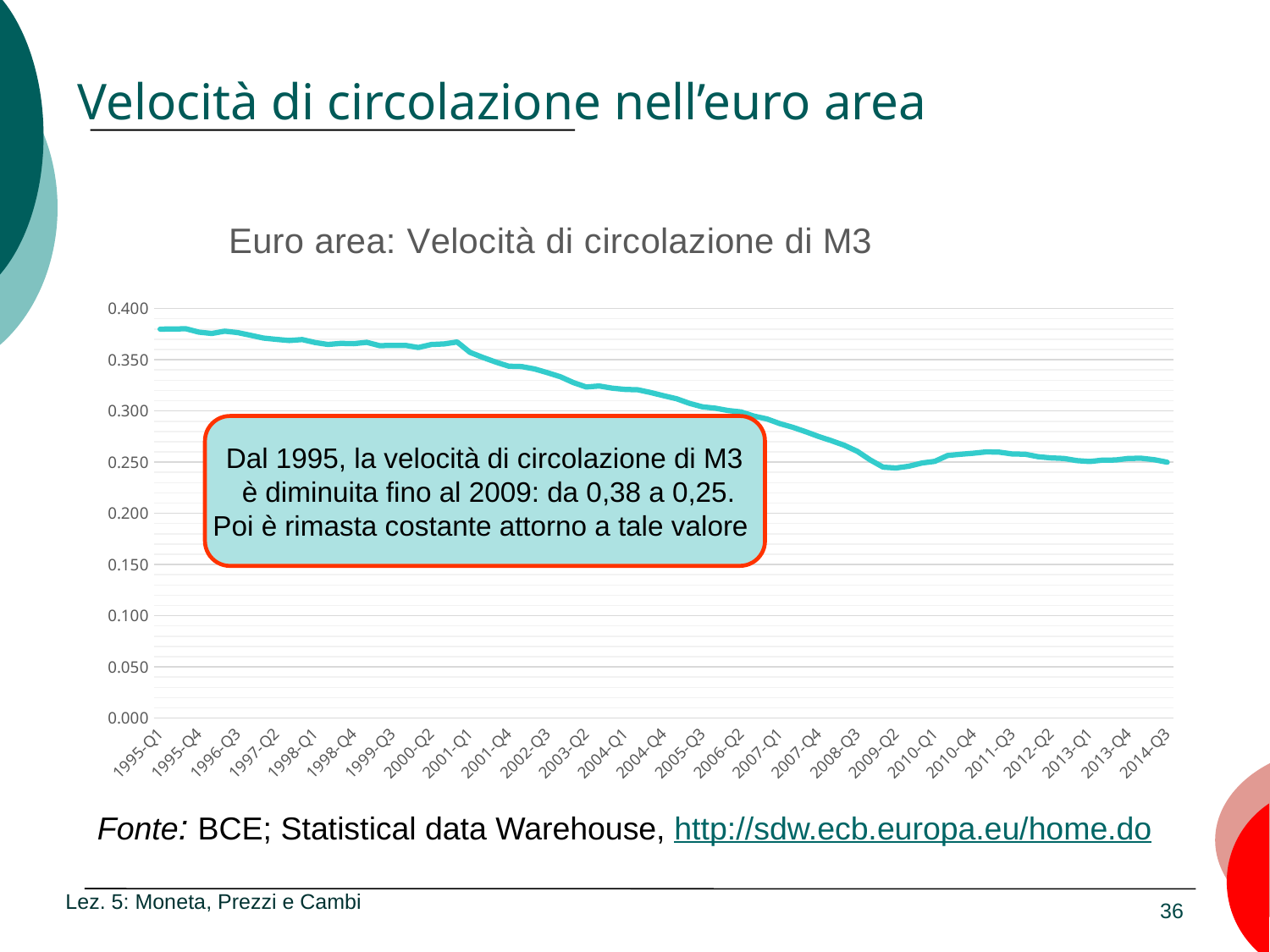
Is the value for 1995-Q1 greater or less than 0.350? greater Does the velocity of circulation of M3 generally rise or fall from 1995-Q1 to 2009-Q2? fall What kind of chart is shown on the slide? line chart What is the title of the chart? Euro area: Velocità di circolazione di M3 Which is larger, the value for 1995-Q1 or the value for 2014-Q3? 1995-Q1 What is the highest value shown on the vertical axis? 0.400 Is the value for 2009-Q2 greater or less than 0.300? less Is the value for 2007-Q1 greater or less than 0.250? greater Which is larger, the value for 2001-Q1 or the value for 2009-Q2? 2001-Q1